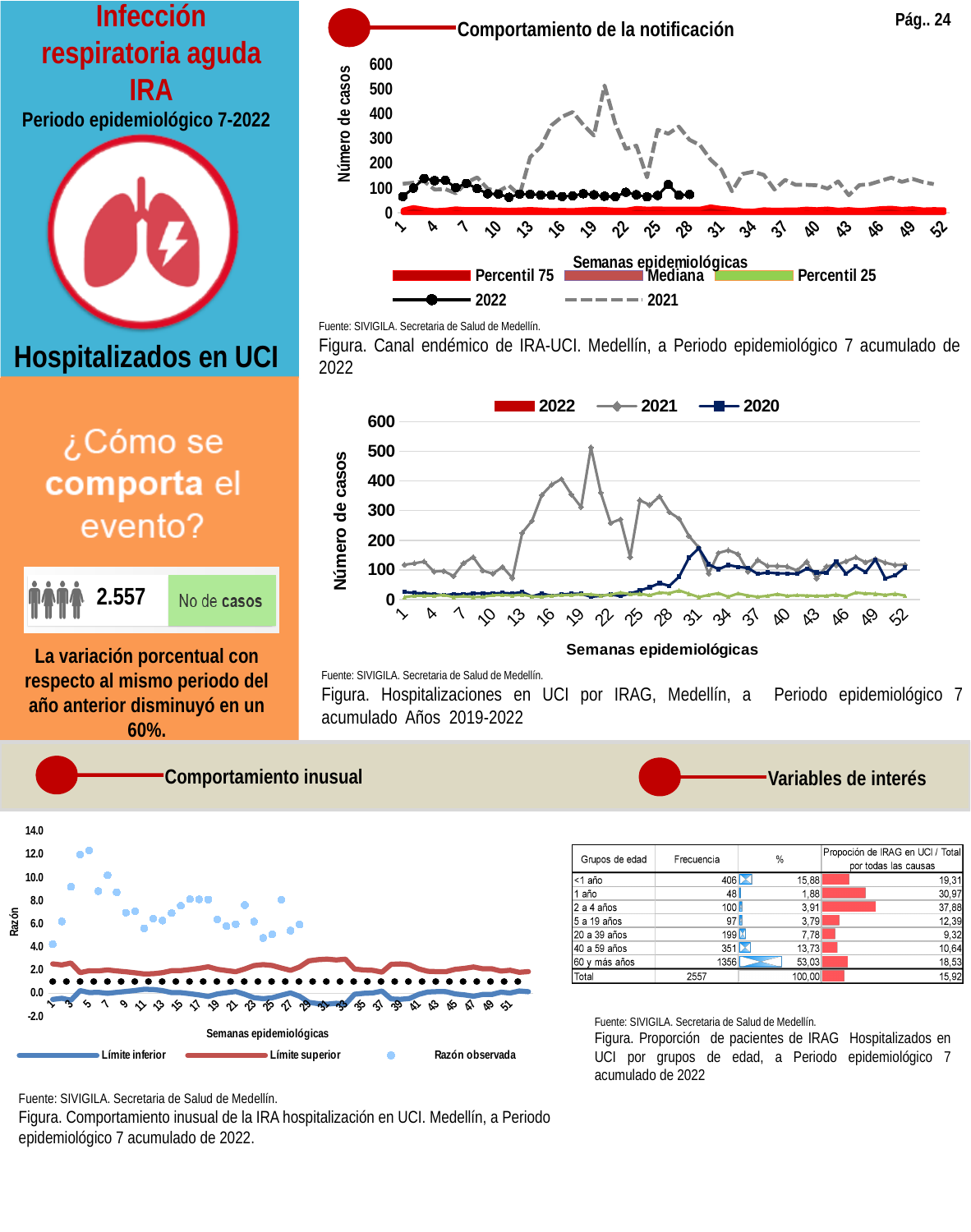
In the chart titled 'Comportamiento inusual', how many series does the legend list? 3 In the chart titled 'Hospitalizaciones en UCI por IRAG', is the value of the 2020 series at week 31 greater or less than 100? greater In the chart titled 'Canal endémico de IRA-UCI', is the value of the 2021 series at week 19 greater or less than 400? less In the chart titled 'Canal endémico de IRA-UCI', is the value of the 2022 series at week 16 greater or less than 200? less In the table titled 'Proporción de pacientes de IRAG Hospitalizados en UCI por grupos de edad', which age group has the lowest Frecuencia? 1 año In the chart titled 'Hospitalizaciones en UCI por IRAG', which years are listed in the legend? 2022, 2021, 2020 In the chart titled 'Canal endémico de IRA-UCI', what kind of chart is shown? Line chart In the table titled 'Proporción de pacientes de IRAG Hospitalizados en UCI por grupos de edad', what is the difference in Frecuencia between '<1 año' and '40 a 59 años'? 55 In the table titled 'Proporción de pacientes de IRAG Hospitalizados en UCI por grupos de edad', what is the Frecuencia for '60 y más años'? 1356 In the chart titled 'Canal endémico de IRA-UCI', how many series does the legend list? 5